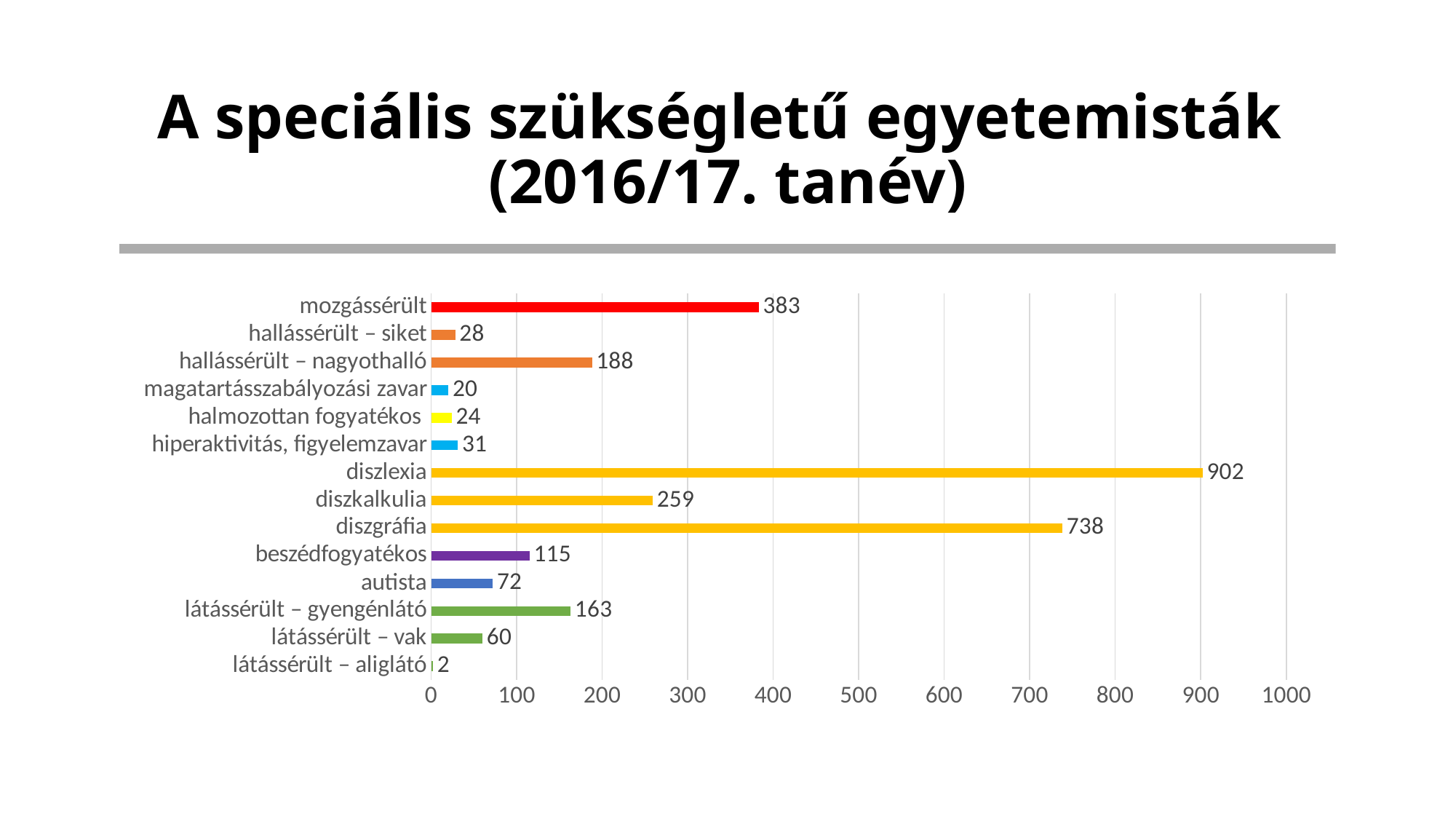
What is the difference between the values for autista and látássérült – vak? 12 What kind of chart is shown on the slide? bar chart How many categories are shown in the chart? 14 What is the difference between the values for diszlexia and diszgráfia? 164 What is the value for diszlexia? 902 Is the value for beszédfogyatékos greater or less than 100? greater Which is larger, the value for hallássérült – nagyothalló or the value for diszkalkulia? diszkalkulia What is the value for látássérült – gyengénlátó? 163 What is the title of the slide? A speciális szükségletű egyetemisták (2016/17. tanév) Which category has the highest value? diszlexia What is the value for mozgássérült? 383 Which category has the lowest value? látássérült – aliglátó